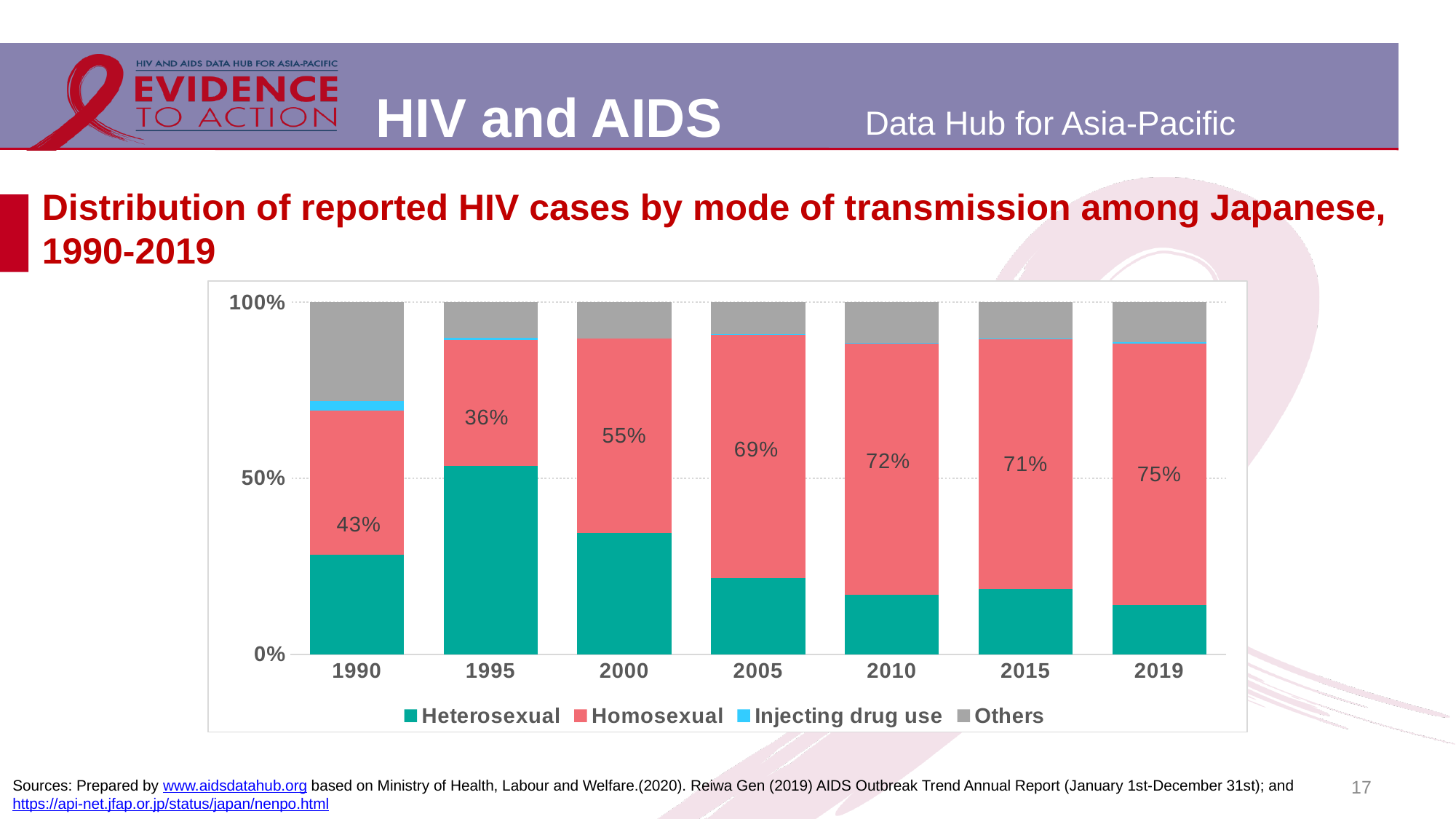
How many modes of transmission does the legend list? 4 By how many percentage points did the Homosexual share increase from 1990 to 2019? 32 percentage points What percentage is shown for the Homosexual segment in 1990? 43% What type of chart is used on this slide? Stacked bar chart How many years are shown on the x axis of the chart? 7 In which year is the Homosexual share the highest? 2019 What share of reported HIV cases among Japanese in 2019 was attributed to homosexual transmission? 75% Is the Heterosexual share in 1995 greater or less than 50%? greater What is the Homosexual share labelled for 2005? 69% Which year has a larger Homosexual share, 2000 or 2010? 2010 In which year is the Homosexual share the lowest? 1995 Is the Heterosexual share in 2019 greater or less than 50%? less